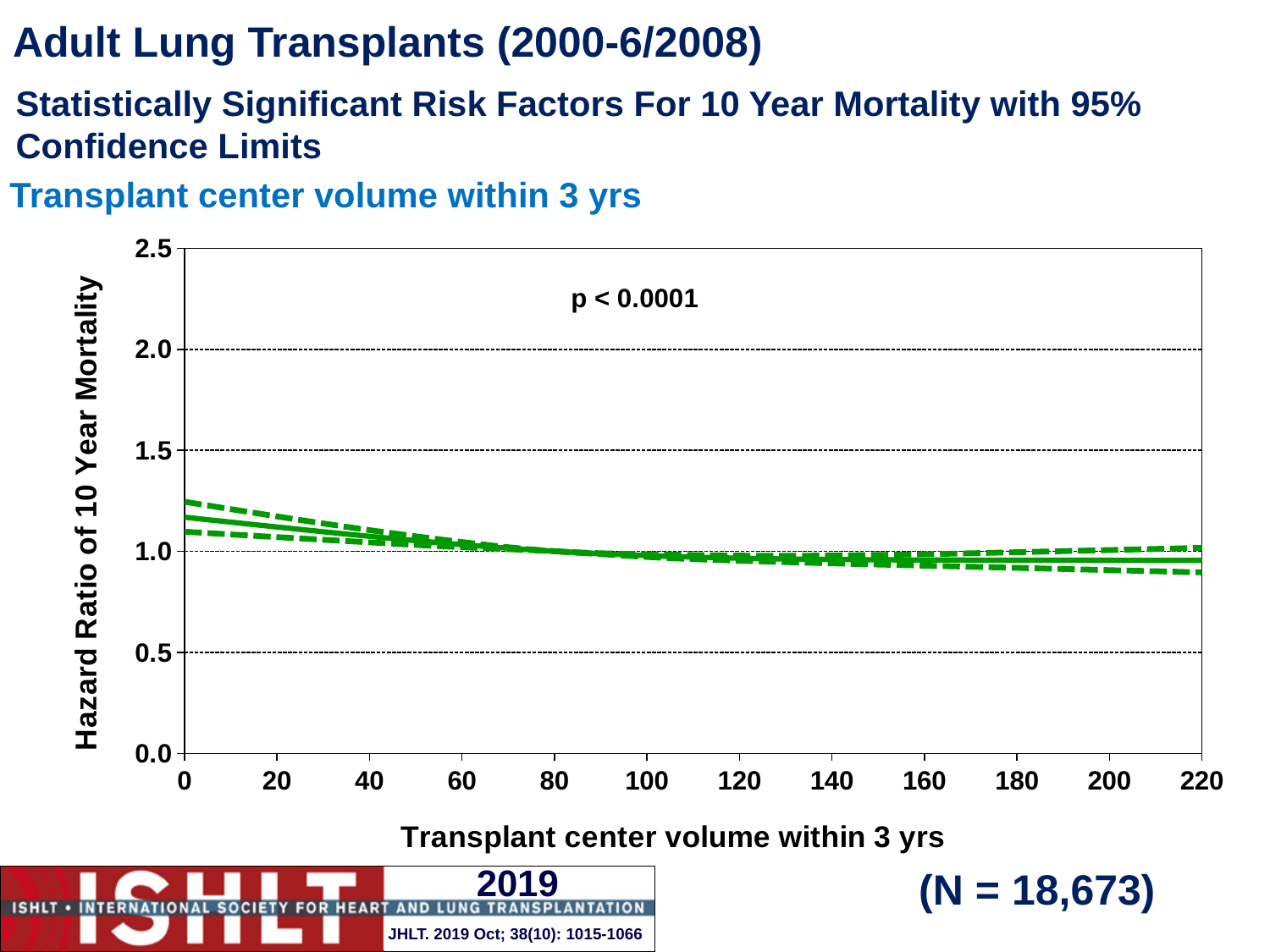
Is the hazard ratio at a transplant center volume of 140 greater or less than 1.5? less How many lines are plotted on the chart? 3 Is the hazard ratio at a transplant center volume of 0 greater or less than 1.0? greater What is the label of the x axis? Transplant center volume within 3 yrs What sample size (N) is shown on the slide? N = 18,673 What kind of chart is shown on the slide? line chart What is the highest value shown on the y axis? 2.5 Does the hazard ratio rise or fall as transplant center volume increases from 0 to 80? fall Is the hazard ratio at a transplant center volume of 0 greater or less than 1.5? less What is the label of the y axis? Hazard Ratio of 10 Year Mortality What p-value is printed on the chart? p < 0.0001 Which is larger, the hazard ratio at a center volume of 0 or at a center volume of 120? 0